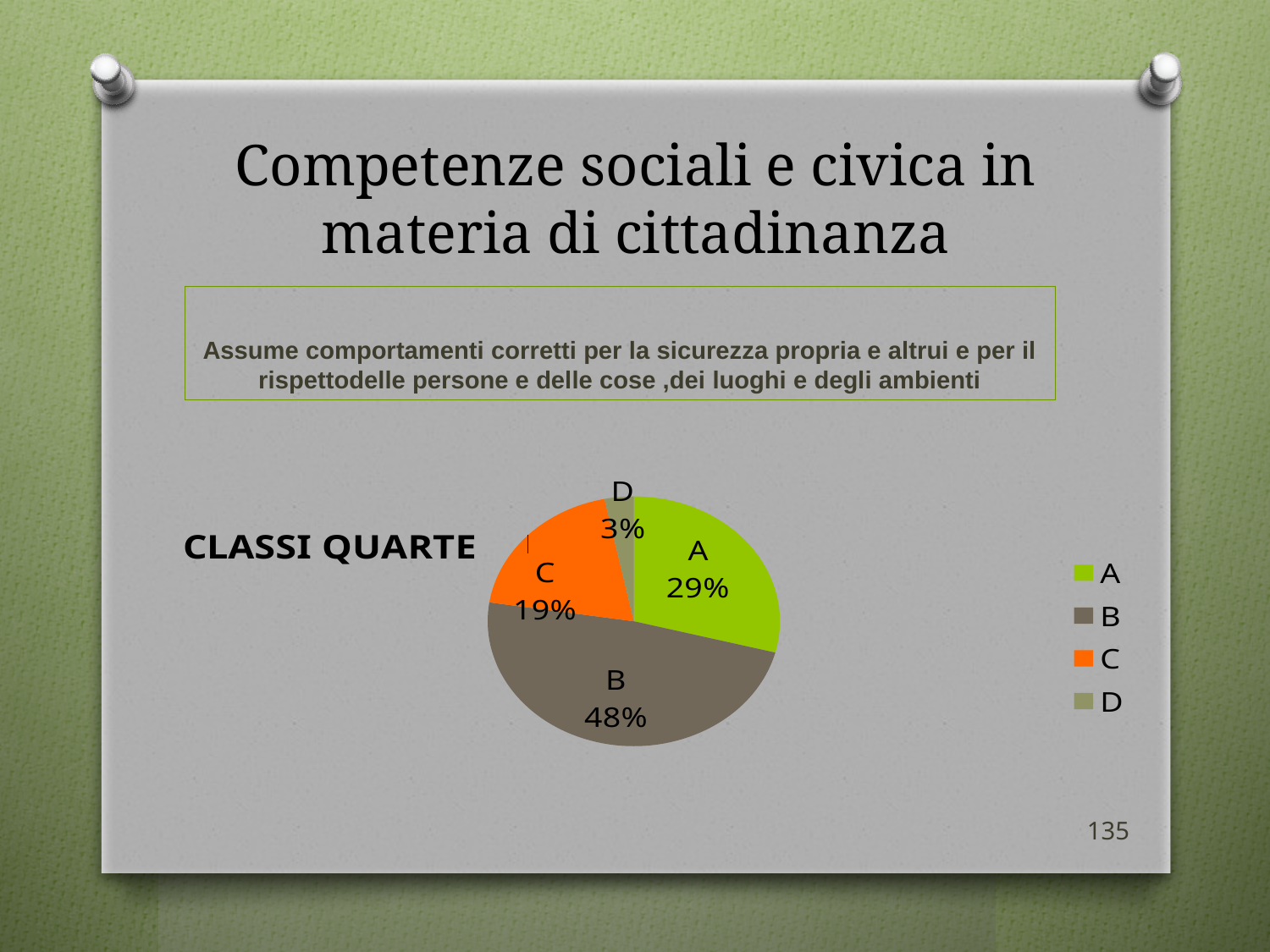
Which slice is the largest in the pie chart? B What is the difference in percentage points between slice B and slice A? 19 Which slice is the smallest in the pie chart? D What percentage of the pie does slice B represent? 48% What colour is slice C in the pie chart? orange What percentage of the pie does slice A represent? 29% Which is larger, slice A or slice C? A How many entries does the legend list? 4 What kind of chart is shown on the slide? pie chart What percentage of the pie does slice C represent? 19% How many slices does the pie chart have? 4 What percentage of the pie does slice D represent? 3%